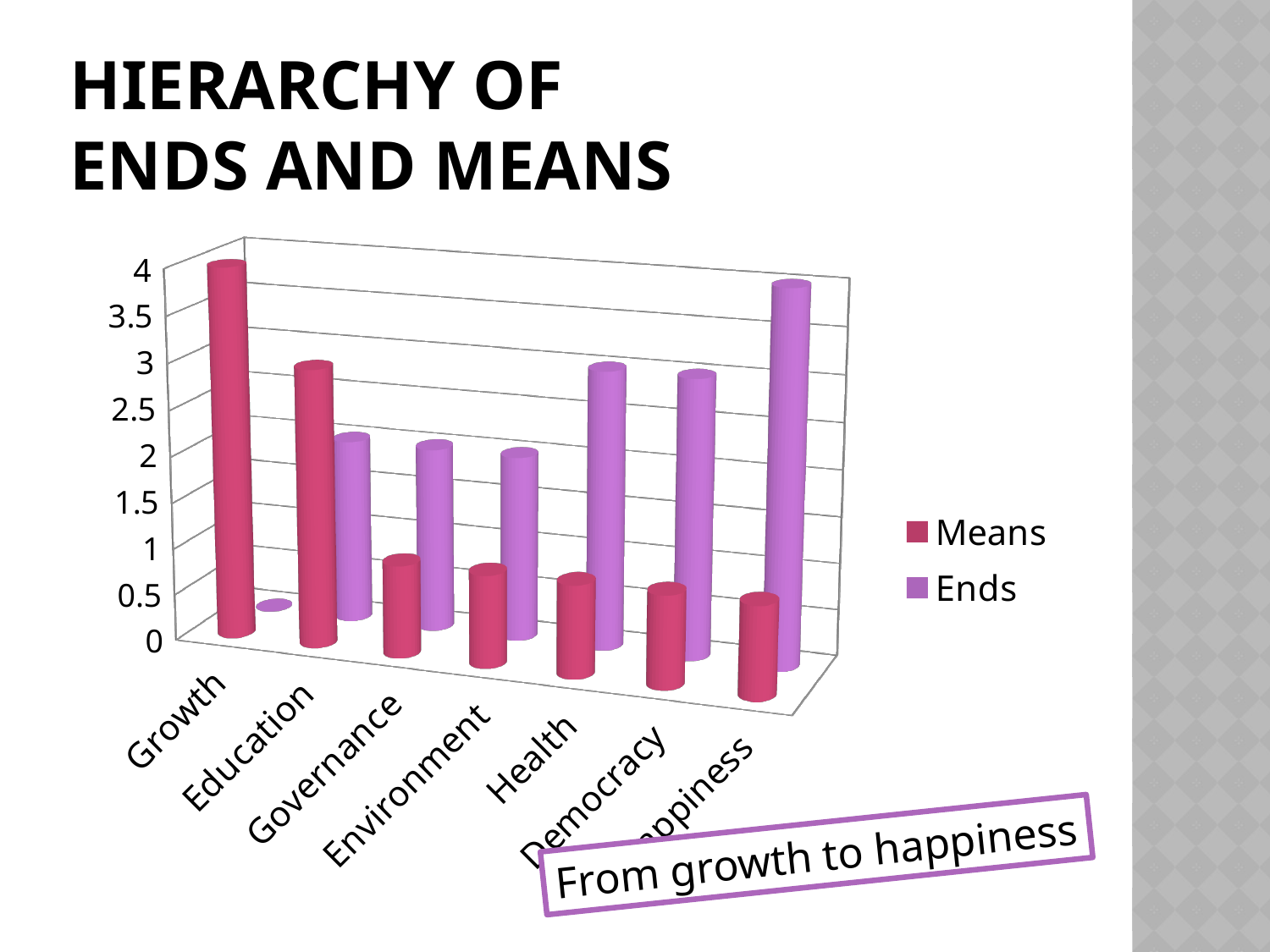
Which category has the highest value for the Ends series? Happiness Which series is shown in purple in the legend? Ends Which category has the lowest value for the Ends series? Growth How many categories are shown on the x axis of the chart? 7 How many series does the legend list? 2 Do the Means values generally rise or fall moving from Growth to Happiness along the x axis? fall Is the Means value for Growth greater or less than 3? greater Is the Ends value for Growth greater or less than 0.5? less Which category has the highest value for the Means series? Growth What kind of chart is shown on the slide? bar chart Is the Means value for Governance greater or less than 1.5? less For Health, which series has the larger value, Means or Ends? Ends